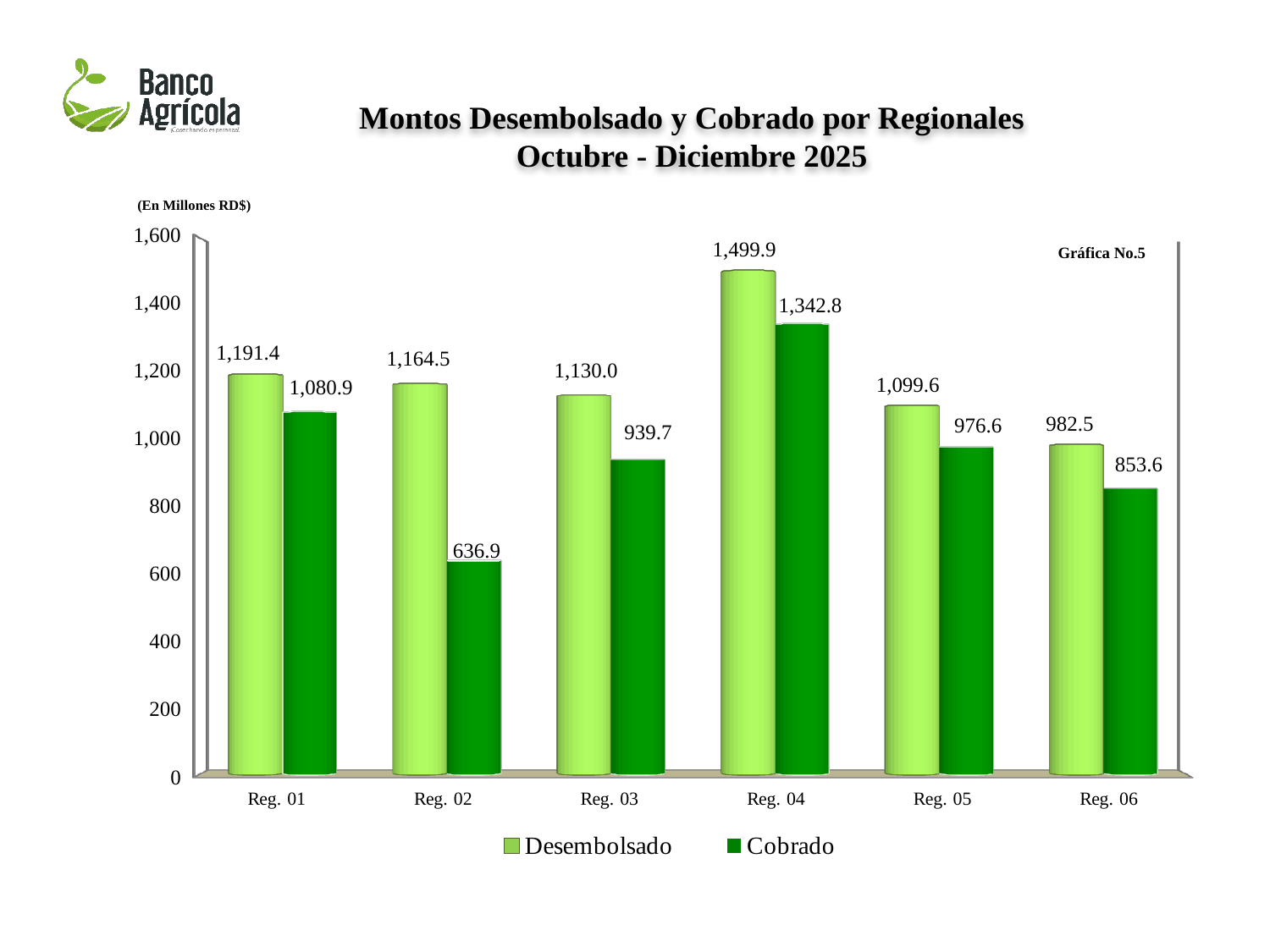
What kind of chart is shown on the slide? Bar chart Which region has the highest Desembolsado value? Reg. 04 How many regions are shown on the x axis? 6 What is the Cobrado value for Reg. 02? 636.9 What unit is stated above the chart? En Millones RD$ What is the Desembolsado value for Reg. 04? 1,499.9 What is the difference between Desembolsado and Cobrado for Reg. 04? 157.1 Which is larger, the Cobrado value for Reg. 03 or the Cobrado value for Reg. 05? Reg. 05 What is the Cobrado value for Reg. 06? 853.6 How many series does the legend list? 2 Which region has the lowest Cobrado value? Reg. 02 What is the difference between Desembolsado and Cobrado for Reg. 02? 527.6